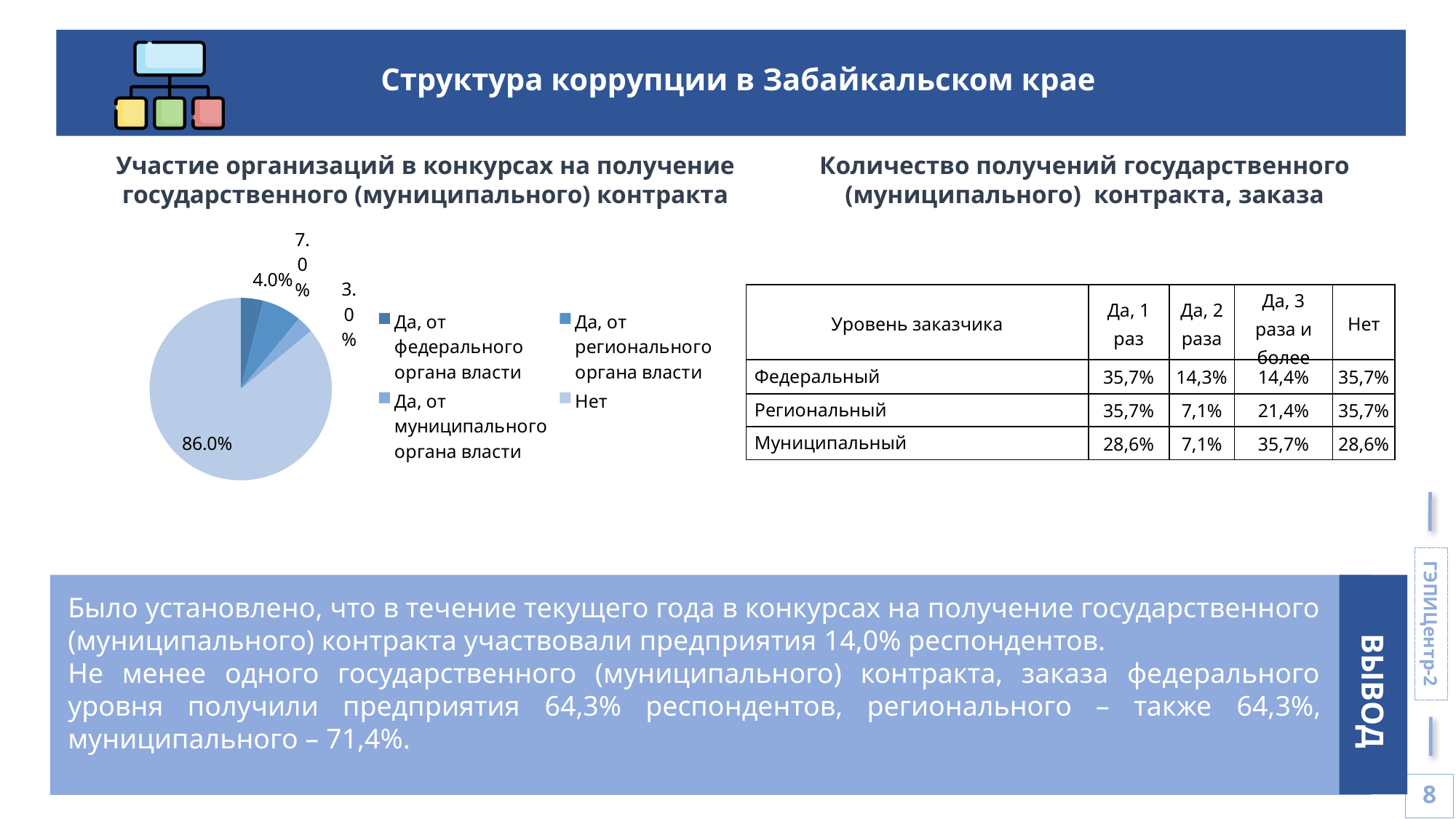
What share of the pie do the three "Да" categories make up together? 14.0% What is the difference between the values for "Нет" and "Да, от регионального органа власти" in the pie chart? 79.0% What is the value for "Нет" in the pie chart? 86.0% Which is larger in the pie chart: "Да, от федерального органа власти" or "Да, от регионального органа власти"? Да, от регионального органа власти How many slices does the pie chart have? 4 What kind of chart is shown on the slide? pie chart Which category has the largest slice in the pie chart? Нет What is the title of the pie chart? Участие организаций в конкурсах на получение государственного (муниципального) контракта What is the value for "Да, от федерального органа власти" in the pie chart? 4.0% Which category has the smallest slice in the pie chart? Да, от муниципального органа власти What is the value for "Да, от муниципального органа власти" in the pie chart? 3.0% What is the value for "Да, от регионального органа власти" in the pie chart? 7.0%